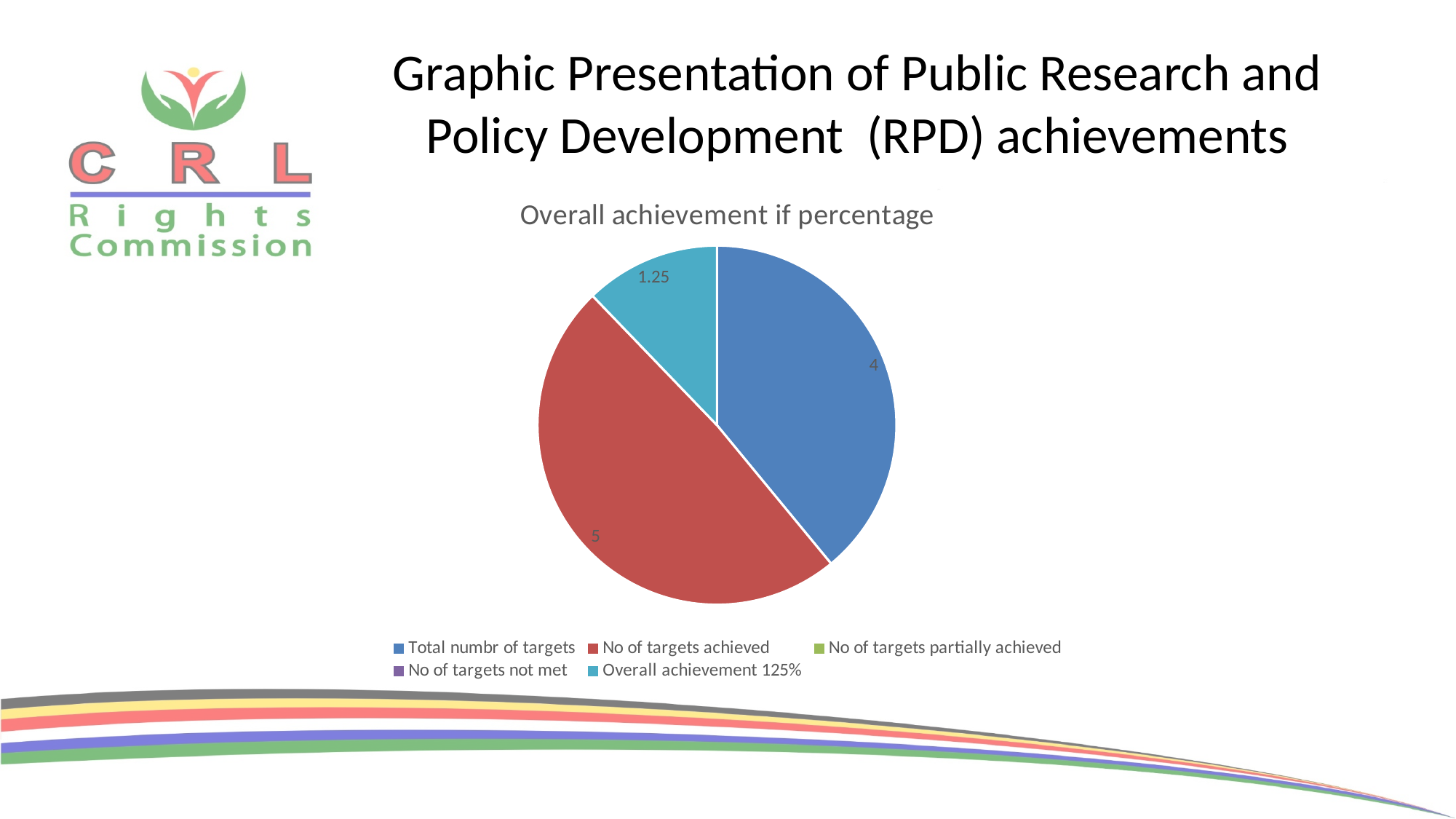
What type of chart is shown on the slide? pie chart Which category has the largest slice of the pie? No of targets achieved Which labelled slice has the smallest value? Overall achievement 125% What is the title of the chart? Overall achievement if percentage What colour is the slice for 'No of targets achieved'? red What value is shown for 'Overall achievement 125%'? 1.25 What is the difference between the values for 'No of targets achieved' and 'Total numbr of targets'? 1 How many slices with data labels are visible in the pie? 3 What value is shown for 'Total numbr of targets'? 4 How many entries does the legend list? 5 Which is larger: the value for 'Total numbr of targets' or the value for 'Overall achievement 125%'? Total numbr of targets What value is shown for 'No of targets achieved'? 5